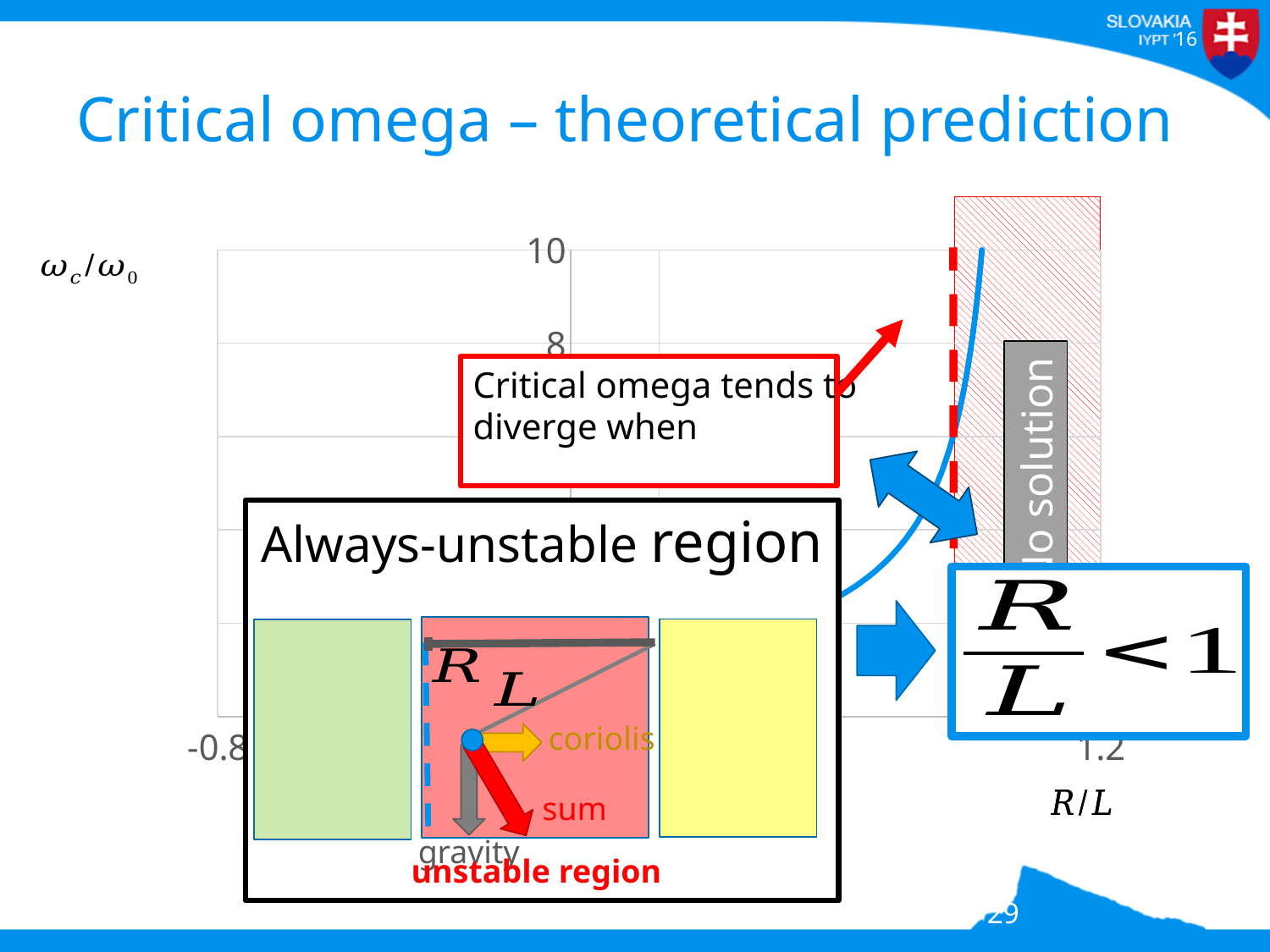
What quantity is labelled on the vertical axis of the chart? ω_c/ω_0 What is the leftmost value shown on the horizontal axis of the chart? -0.8 Does the plotted curve rise or fall as R/L increases toward the dashed red line? rise What is the highest value shown on the vertical axis of the chart? 10 What quantity is labelled on the horizontal axis of the chart? R/L What kind of chart is shown on the slide? line chart